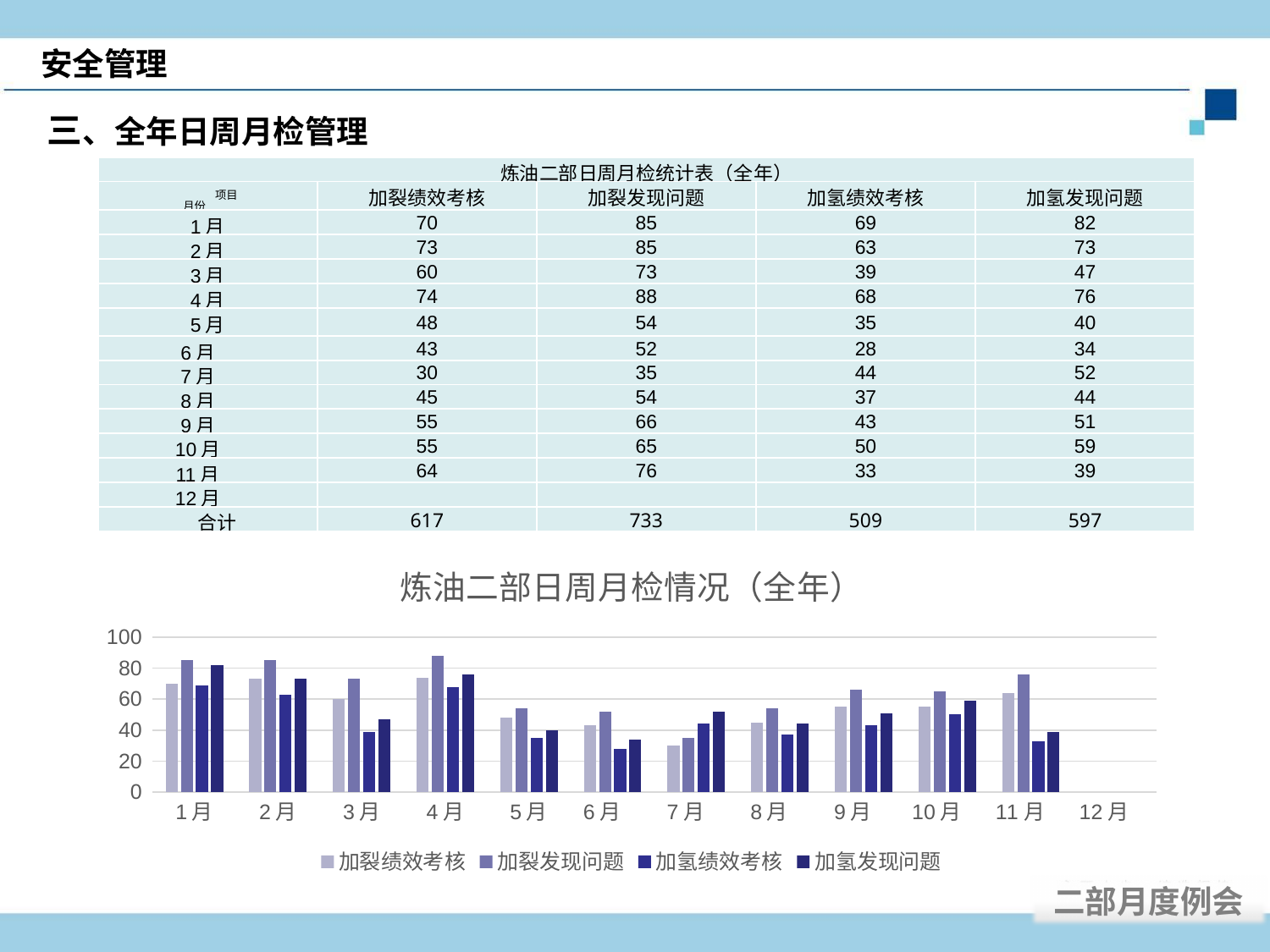
What is the value of 加氢绩效考核 for 6月? 28 How many series does the chart legend list? 4 Which is larger in 7月: 加氢绩效考核 or 加裂绩效考核? 加氢绩效考核 Is the value for 加氢发现问题 in 2月 greater or less than 60? greater Which month has the highest value for 加裂发现问题? 4月 What is the title of the chart? 炼油二部日周月检情况（全年） How many month categories are shown on the x axis of the chart? 12 What kind of chart is shown on the slide? bar chart What is the value of 加裂发现问题 for 4月? 88 Which month has the lowest value for 加裂绩效考核? 7月 Does the value of 加裂绩效考核 rise or fall from 4月 to 7月? fall What is the difference between 加裂发现问题 and 加裂绩效考核 in 1月? 15